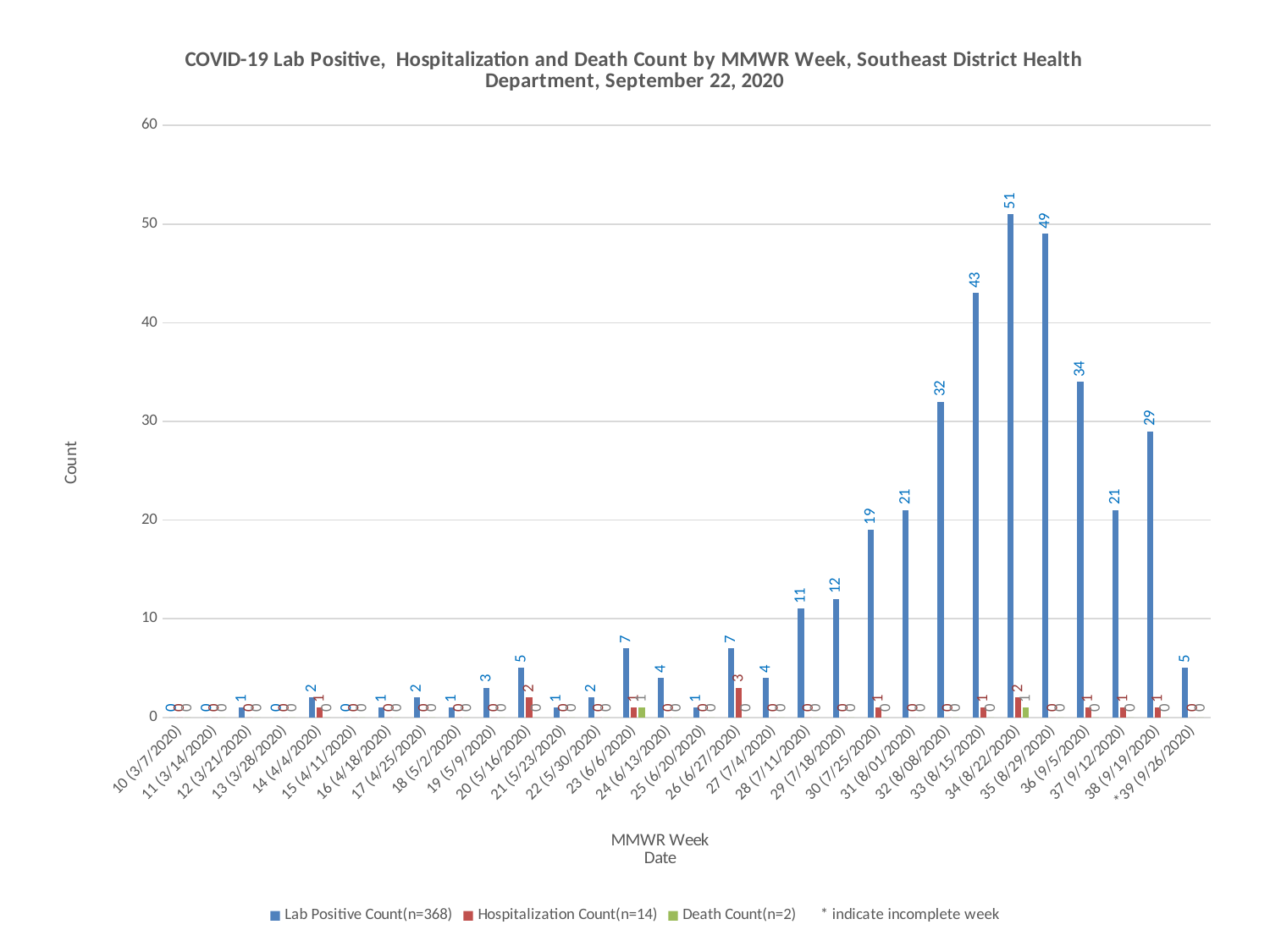
What is the Lab Positive Count for MMWR week 33 (8/15/2020)? 43 What is the Death Count for MMWR week 23 (6/6/2020)? 1 What is the difference between the Lab Positive Count for week 33 (8/15/2020) and week 32 (8/08/2020)? 11 How many series does the legend list? 3 What total n does the legend give for the Lab Positive Count series? n=368 What is the Hospitalization Count for MMWR week 26 (6/27/2020)? 3 Which MMWR week has the highest Lab Positive Count? 34 (8/22/2020) How many MMWR weeks are shown on the x axis? 30 What kind of chart is shown on the slide? Bar chart Does the Lab Positive Count rise or fall from week 28 (7/11/2020) to week 34 (8/22/2020)? Rise Which has a larger Lab Positive Count, week 36 (9/5/2020) or week 38 (9/19/2020)? 36 (9/5/2020) What is the difference between the Lab Positive Count for week 34 (8/22/2020) and week 35 (8/29/2020)? 2